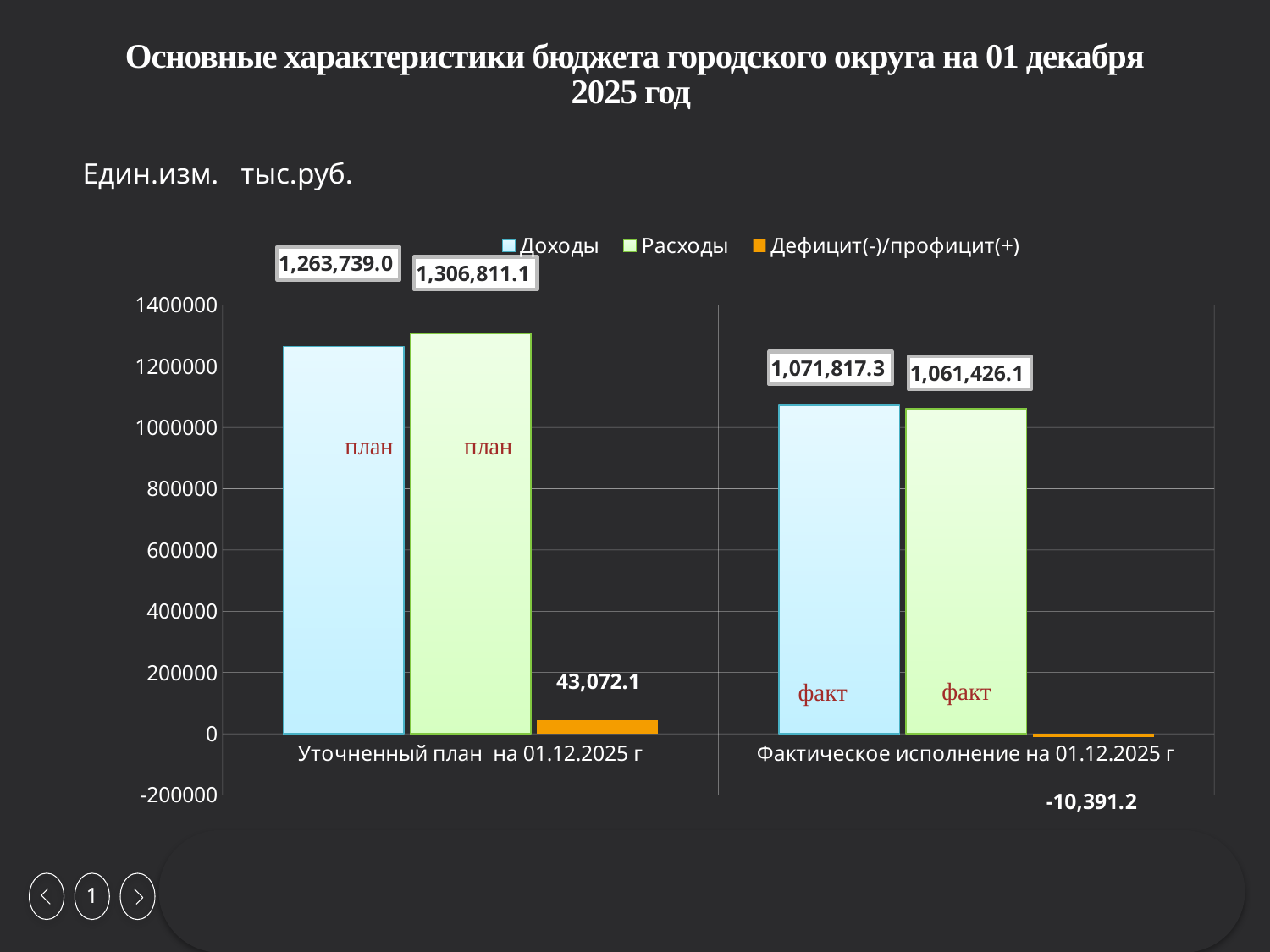
How many series does the legend list? 3 What is the value of Расходы for Фактическое исполнение на 01.12.2025 г? 1,061,426.1 Which is larger for Фактическое исполнение на 01.12.2025 г: Доходы or Расходы? Доходы What is the value of Доходы for Фактическое исполнение на 01.12.2025 г? 1,071,817.3 What is the value of Доходы for Уточненный план на 01.12.2025 г? 1,263,739.0 What kind of chart is shown on the slide? Bar chart What is the value of Расходы for Уточненный план на 01.12.2025 г? 1,306,811.1 What is the value of Дефицит(-)/профицит(+) for Уточненный план на 01.12.2025 г? 43,072.1 What is the difference between Расходы and Доходы for Уточненный план на 01.12.2025 г? 43,072.1 What is the value of Дефицит(-)/профицит(+) for Фактическое исполнение на 01.12.2025 г? -10,391.2 What unit of measurement is stated on the slide for the chart values? тыс.руб. What is the difference between Доходы and Расходы for Фактическое исполнение на 01.12.2025 г? 10,391.2